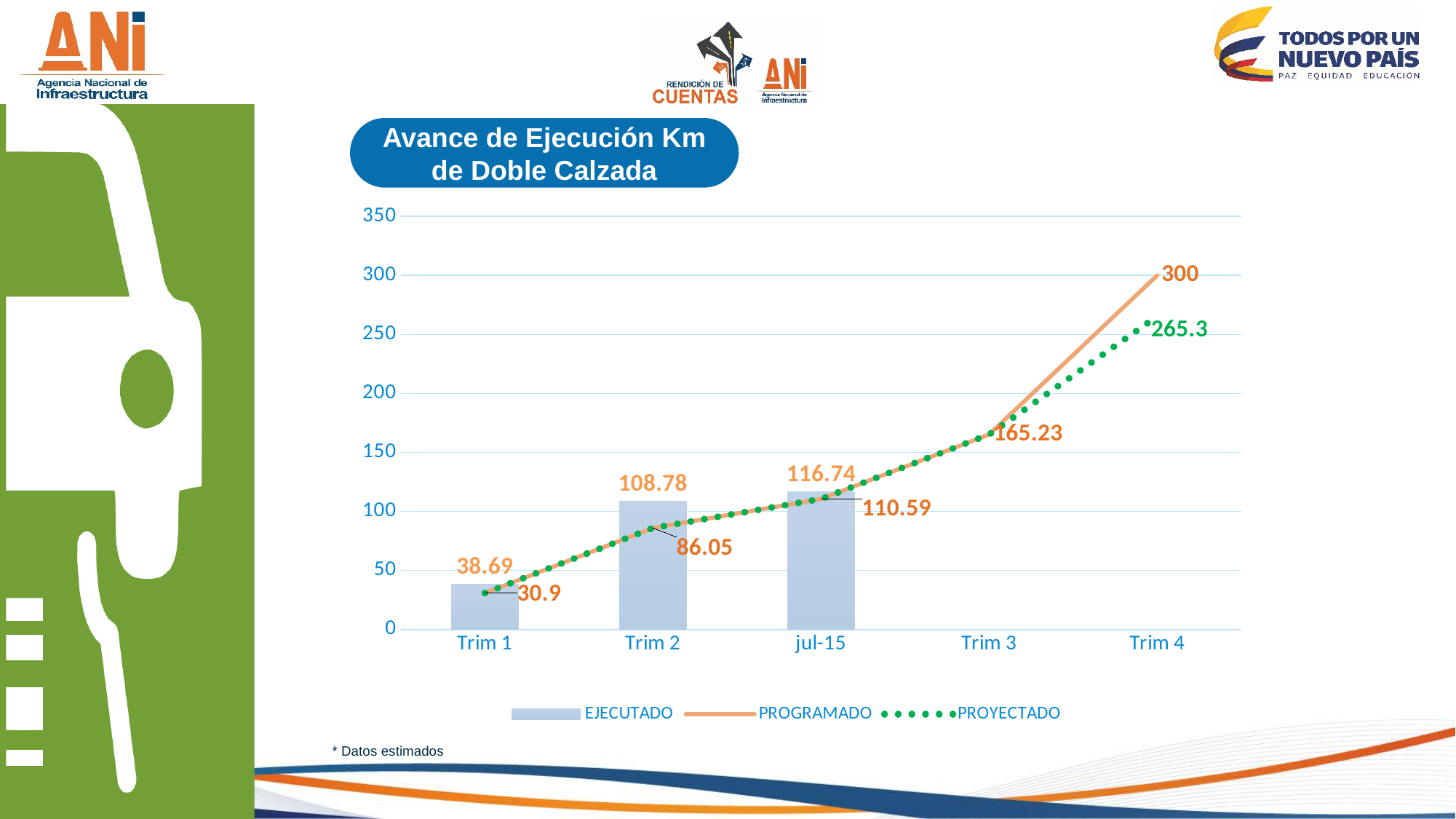
What kind of chart is this? Combination bar and line chart What is the difference between the PROGRAMADO and PROYECTADO values at Trim 4? 34.7 What value is labelled above the EJECUTADO bar for jul-15? 116.74 Is the line value at Trim 3 greater or less than 150? greater Which category has the lowest EJECUTADO bar? Trim 1 Does the PROGRAMADO line rise or fall from Trim 1 to Trim 4? Rises What is the PROGRAMADO value labelled at Trim 4? 300 What is the title of the chart? Avance de Ejecución Km de Doble Calzada What is the PROYECTADO value labelled at Trim 4? 265.3 How many categories are shown on the x axis? 5 How many series does the legend list? 3 What value is labelled above the EJECUTADO bar for Trim 2? 108.78